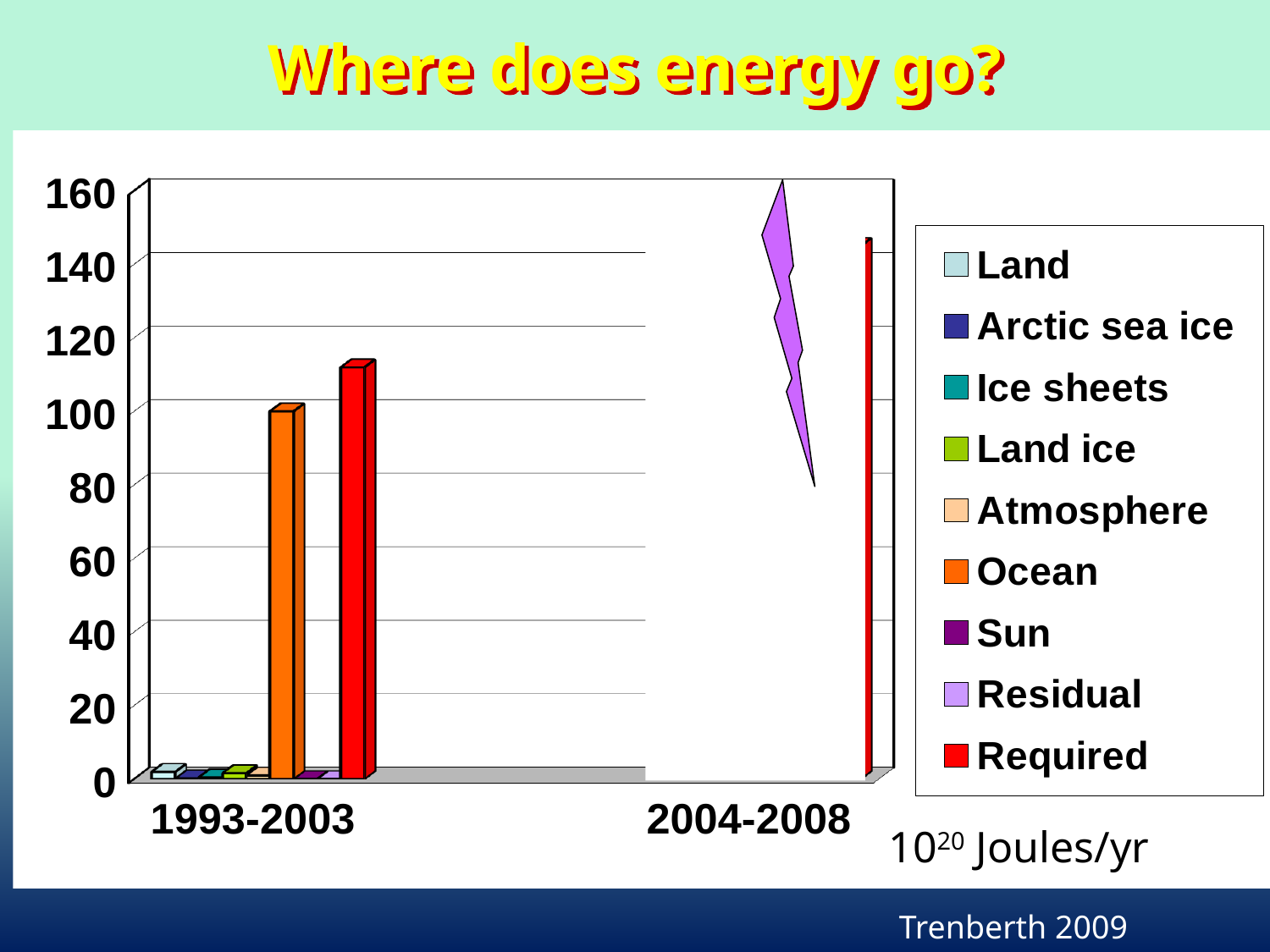
Is the value for Ocean in 1993-2003 greater or less than 80? greater What unit is given for the values on the chart? 10^20 Joules/yr Which series has the tallest bar in the 1993-2003 category? Required Which is larger, the Required bar for 1993-2003 or the Required bar for 2004-2008? 2004-2008 What kind of chart is shown on the slide? bar chart Is the value for Required in 1993-2003 greater or less than 120? less Which is larger in 1993-2003, the Ocean bar or the Required bar? Required Is the value for Required in 2004-2008 greater or less than 140? greater What is the title of the slide containing the chart? Where does energy go? How many series does the chart legend list? 9 How many categories are shown on the x axis of the chart? 2